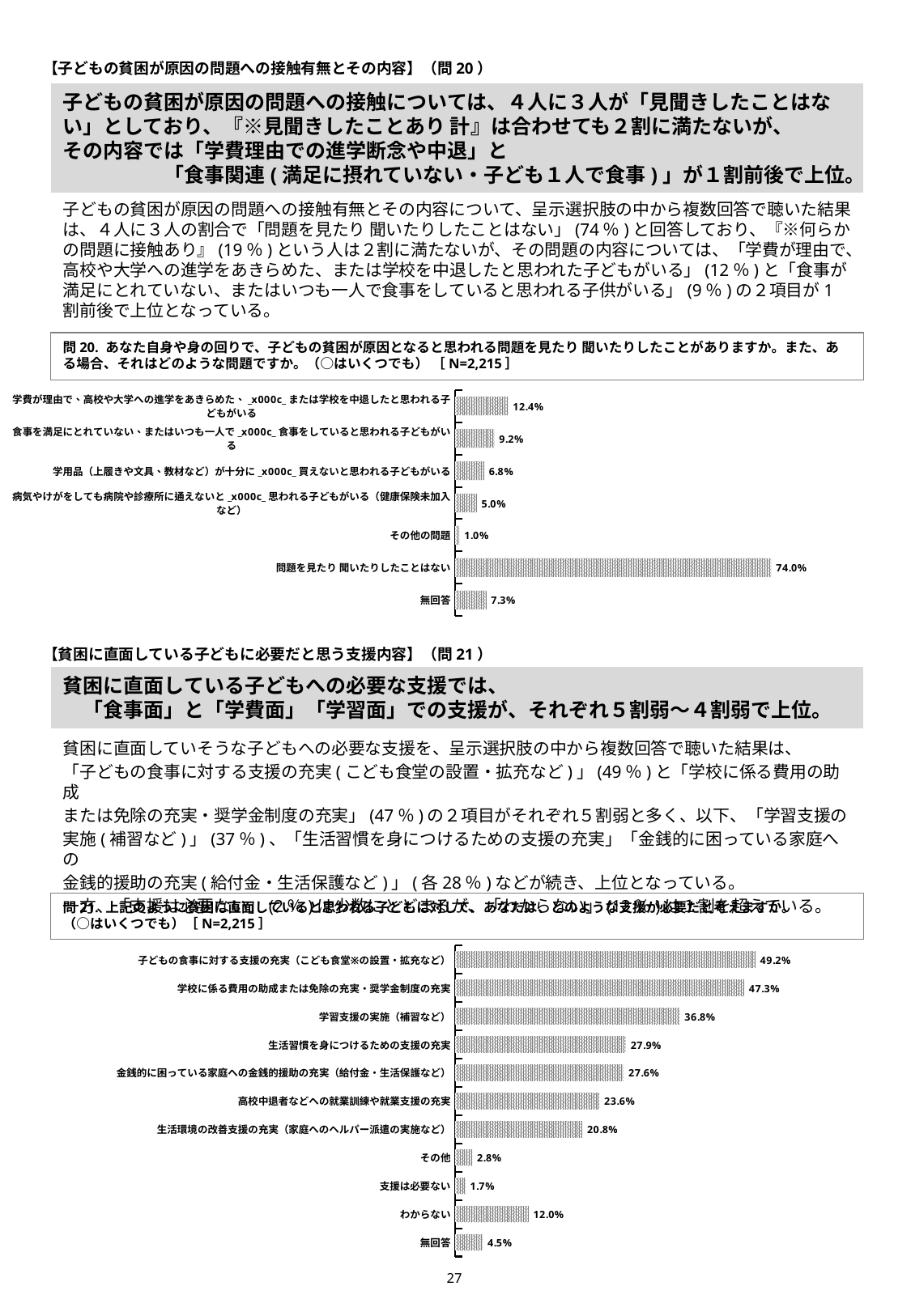
In the bottom chart (問21), which is larger: 「高校中退者などへの就業訓練や就業支援の充実」 or 「生活環境の改善支援の充実（家庭へのヘルパー派遣の実施など）」? 高校中退者などへの就業訓練や就業支援の充実 In the top chart (問20), what is the value for 「問題を見たり 聞いたりしたことはない」? 74.0% In the bottom chart (問21), what is the value for 「学習支援の実施（補習など）」? 36.8% In the top chart (問20), which category has the lowest value? その他の問題 In the top chart (問20), how many categories are plotted? 7 In the bottom chart (問21), which category has the highest value? 子どもの食事に対する支援の充実（こども食堂※の設置・拡充など） In the bottom chart (問21), what is the value for 「わからない」? 12.0% In the top chart (問20), what is the difference between 「無回答」 (7.3%) and 「学用品（上履きや文具、教材など）が十分に買えないと思われる子どもがいる」 (6.8%)? 0.5% In the bottom chart (問21), how many categories are plotted? 11 What kind of chart is the bottom chart (問21)? Bar chart In the bottom chart (問21), which category has the lowest value? 支援は必要ない In the top chart (問20), what is the value for 「その他の問題」? 1.0%